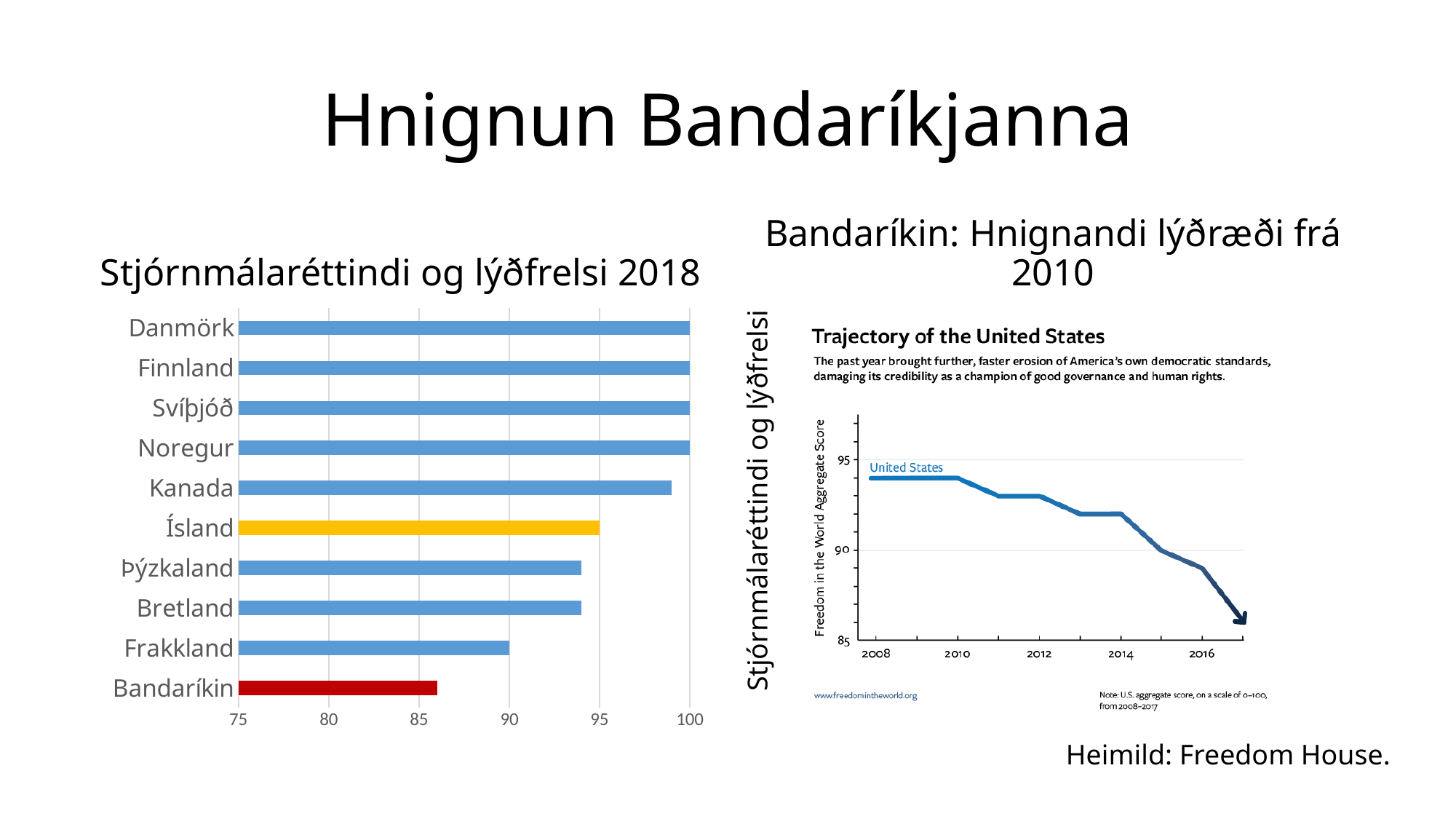
On the chart titled 'Stjórnmálaréttindi og lýðfrelsi 2018', is the value for Bandaríkin greater or less than 90? less On the chart titled 'Stjórnmálaréttindi og lýðfrelsi 2018', what is the value for Danmörk? 100 On the chart titled 'Stjórnmálaréttindi og lýðfrelsi 2018', what kind of chart is shown? Bar chart On the chart titled 'Stjórnmálaréttindi og lýðfrelsi 2018', is the value for Kanada greater or less than 95? greater On the chart titled 'Stjórnmálaréttindi og lýðfrelsi 2018', what is the difference between the values for Ísland and Frakkland? 5 On the chart titled 'Stjórnmálaréttindi og lýðfrelsi 2018', how many countries are listed? 10 On the chart titled 'Stjórnmálaréttindi og lýðfrelsi 2018', what colour is the bar for Bandaríkin? Red On the chart titled 'Stjórnmálaréttindi og lýðfrelsi 2018', which country has the lowest value? Bandaríkin On the chart titled 'Stjórnmálaréttindi og lýðfrelsi 2018', what is the value for Frakkland? 90 On the chart titled 'Stjórnmálaréttindi og lýðfrelsi 2018', what is the value for Ísland? 95 On the chart titled 'Trajectory of the United States', do the values rise or fall from 2010 to 2017? Fall On the chart titled 'Stjórnmálaréttindi og lýðfrelsi 2018', which is larger, the value for Ísland or the value for Frakkland? Ísland